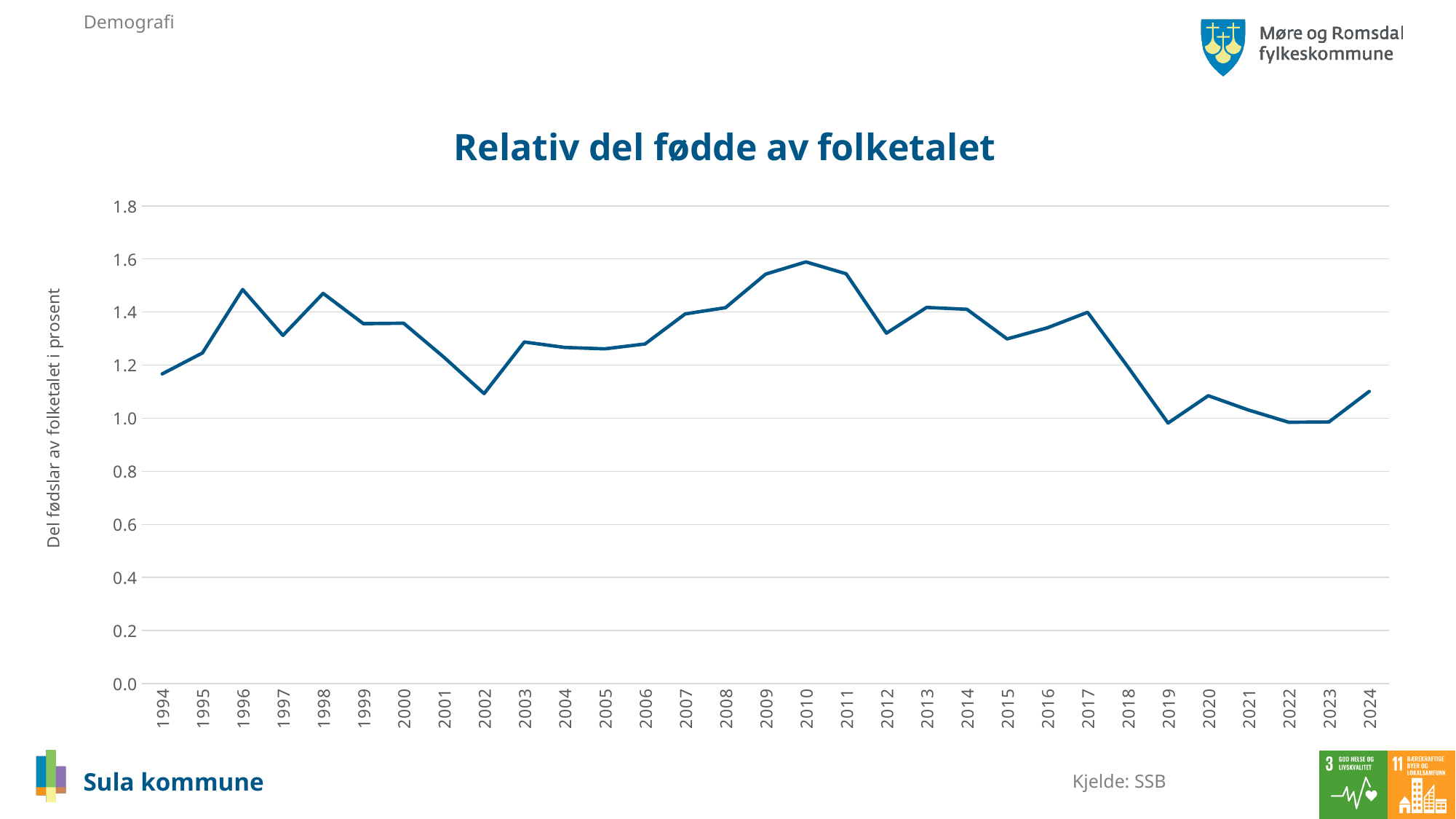
What is the label on the vertical axis of the chart? Del fødslar av folketalet i prosent Which year has the larger value, 2010 or 2019? 2010 Is the value for 1996 greater or less than 1.4? greater Is the value for 2010 greater or less than 1.4? greater Is the value for 2002 greater or less than 1.2? less How many years are plotted along the x axis of the chart? 31 In which year does the line reach its highest value? 2010 Which year has the larger value, 1996 or 1997? 1996 Does the line rise or fall between 2017 and 2019? fall What kind of chart is shown on the slide? line chart What is the title of the chart? Relativ del fødde av folketalet